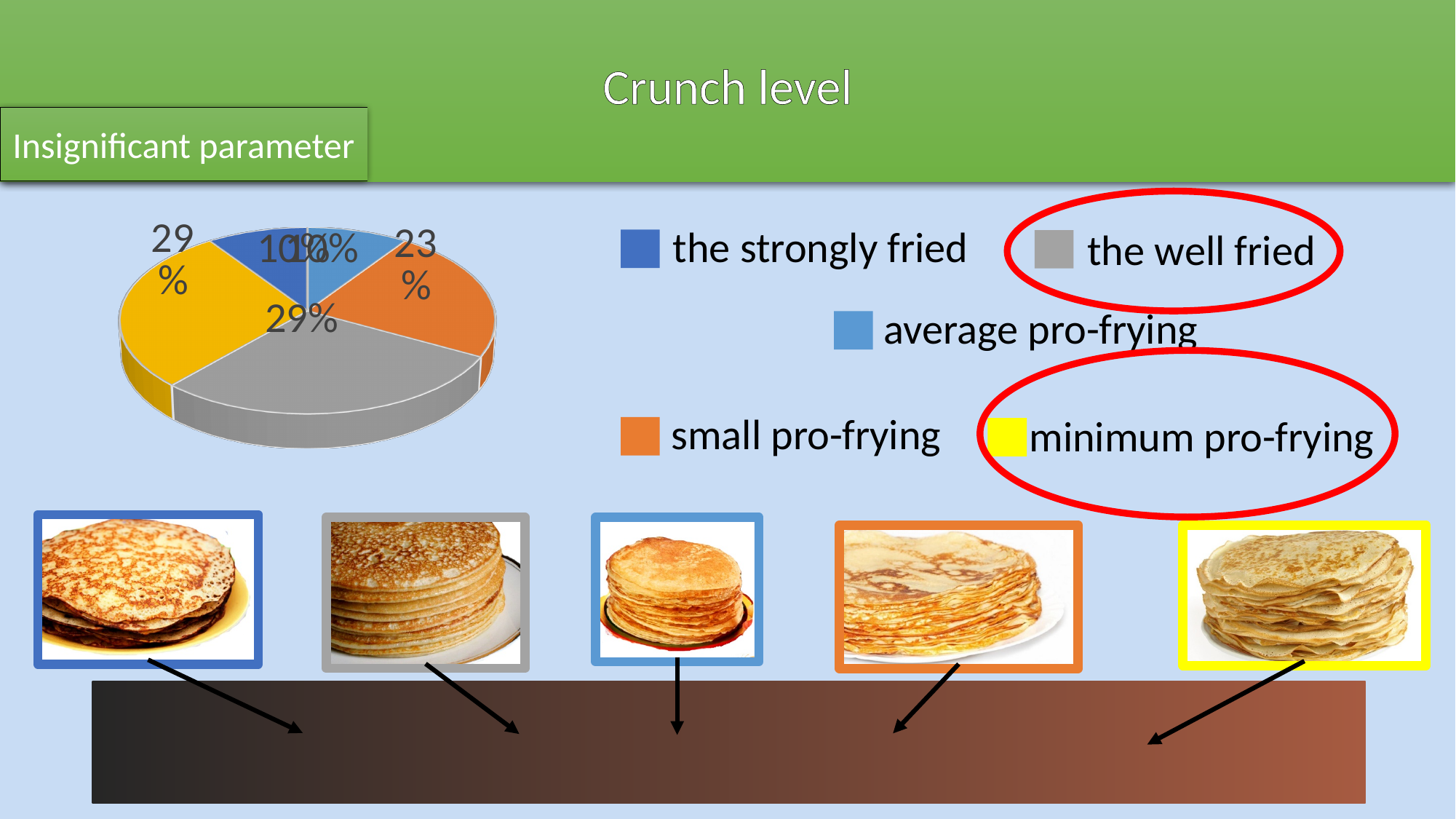
What kind of chart is shown on the slide? pie chart Is the value for "small pro-frying" greater or less than 25%? less How many slices does the pie chart have? 5 What is the difference between the values for "the well fried" and "small pro-frying"? 6% What is the value shown for "small pro-frying" in the pie chart? 23% What share of the pie does "the well fried" take? 29% Which colour represents "minimum pro-frying" in the pie chart? yellow What share of the pie does "minimum pro-frying" take? 29% What is the title of the slide containing the pie chart? Crunch level Which is larger in the pie chart, "small pro-frying" or "the well fried"? the well fried How many entries does the legend of the pie chart list? 5